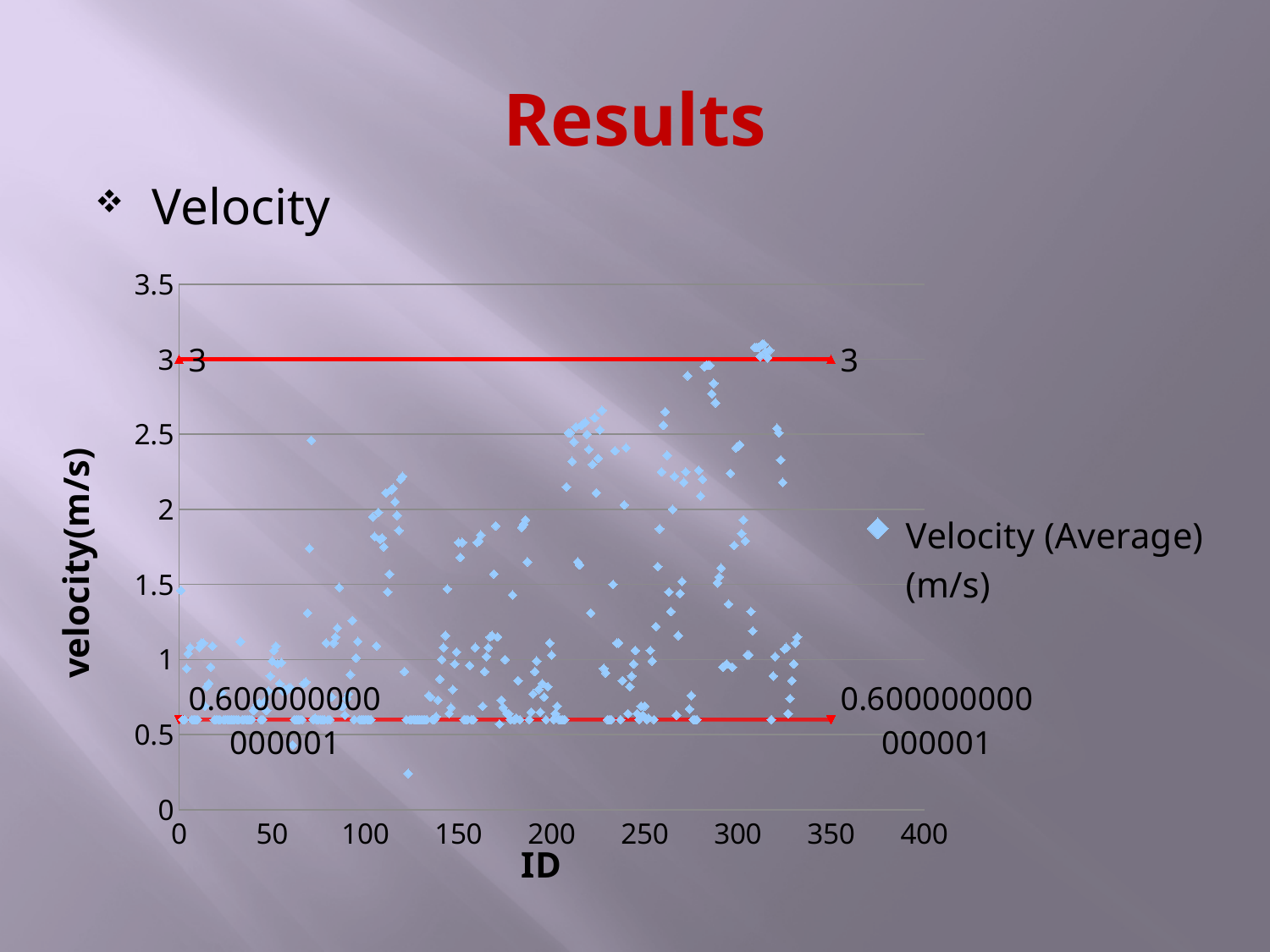
Is the upper red horizontal line greater or less than 2.5 on the vertical axis? greater How many series does the chart's legend list? 1 What value is labelled on the upper red horizontal line? 3 Which of the two red horizontal lines is higher, the one labelled 3 or the one labelled 0.600000000000001? the one labelled 3 What value is labelled on the lower red horizontal line? 0.600000000000001 What kind of chart is shown on the slide? scatter chart What is the difference between the values of the two red horizontal lines? 2.4 What is the title of the vertical axis? velocity(m/s) Is the lower red horizontal line greater or less than 1 on the vertical axis? less What is the legend entry for the plotted points? Velocity (Average) (m/s) What is the highest tick value shown on the horizontal ID axis? 400 What is the highest tick value shown on the vertical axis? 3.5